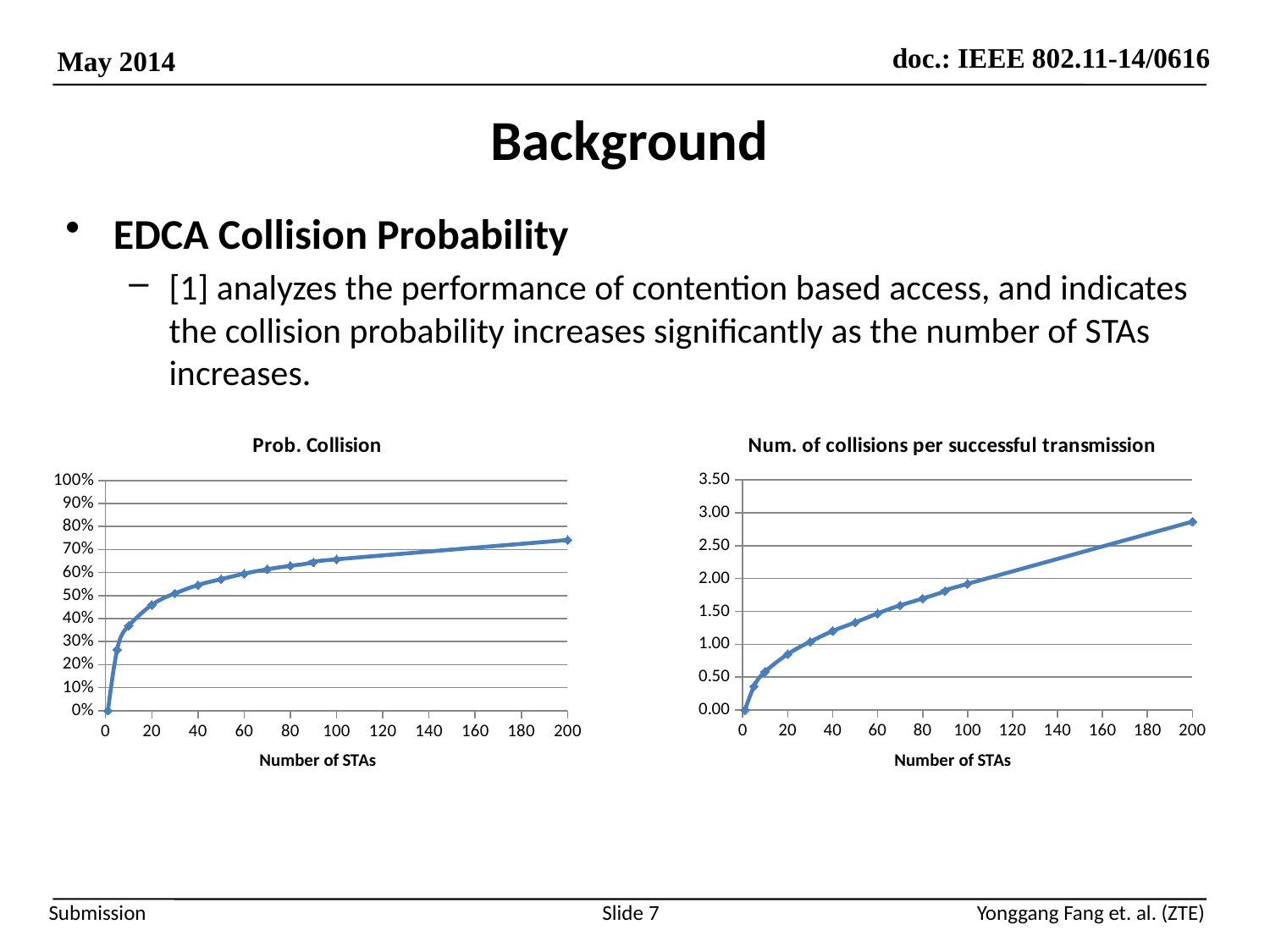
In the 'Num. of collisions per successful transmission' chart, is the value at 200 STAs greater or less than 3.00? less In the 'Num. of collisions per successful transmission' chart, is the value at 40 STAs greater or less than 1.00? greater What kind of chart is the 'Num. of collisions per successful transmission' chart? line chart In the 'Prob. Collision' chart, do the values rise or fall as the number of STAs increases? rise In the 'Prob. Collision' chart, which has the higher value: 100 STAs or 200 STAs? 200 STAs What is the x-axis title of the 'Num. of collisions per successful transmission' chart? Number of STAs In the 'Num. of collisions per successful transmission' chart, do the values rise or fall as the number of STAs increases? rise What kind of chart is the 'Prob. Collision' chart? line chart In the 'Prob. Collision' chart, is the value at 200 STAs greater or less than 70%? greater